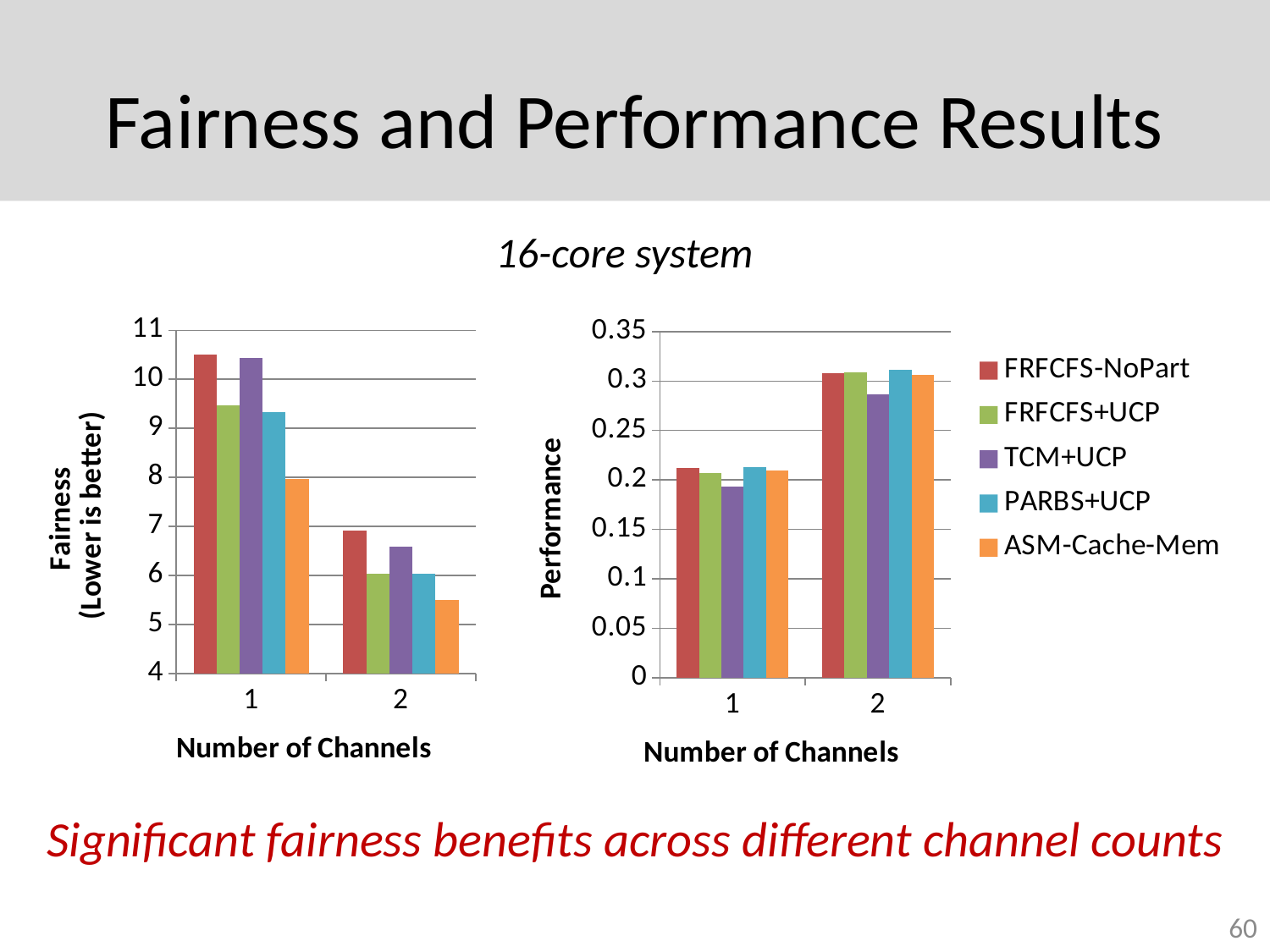
In the left chart (Fairness), which series has the lowest value for 1 channel? ASM-Cache-Mem In the left chart (Fairness), which series has the lowest value for 2 channels? ASM-Cache-Mem In the left chart (Fairness), is the value for FRFCFS-NoPart at 1 channel greater or less than 10? greater What kind of chart is the left chart (Fairness)? bar chart How many series does the legend list? 5 In the left chart (Fairness), which series has the highest value for 2 channels? FRFCFS-NoPart In the right chart (Performance), do the values for FRFCFS-NoPart rise or fall from 1 channel to 2 channels? rise In the left chart (Fairness), how many channel-count categories are shown on the x axis? 2 What is the x-axis label of the right chart (Performance)? Number of Channels In the right chart (Performance), which series has the lowest value for 1 channel? TCM+UCP In the right chart (Performance), is the value for TCM+UCP at 2 channels greater or less than 0.3? less